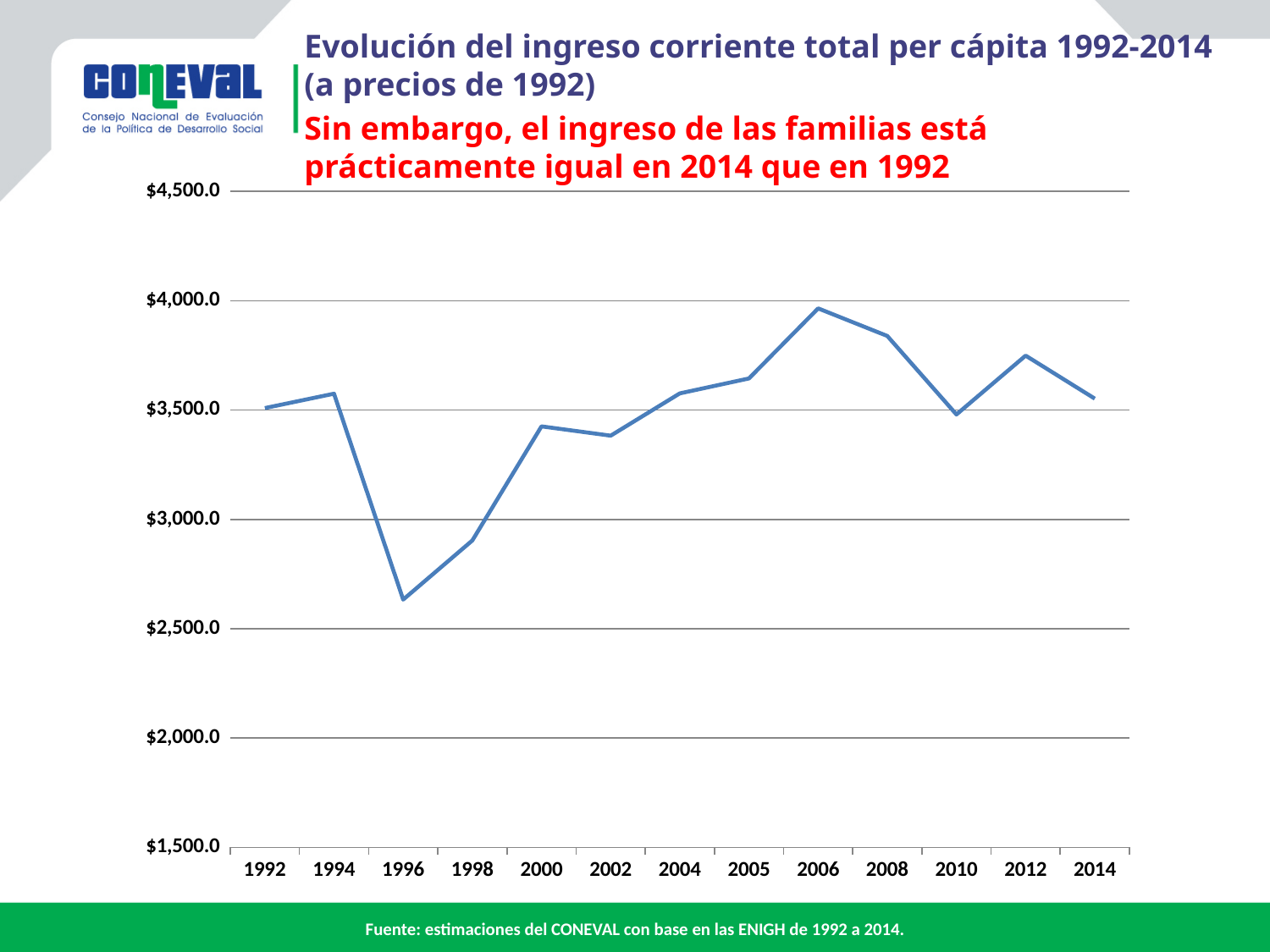
Is the value for 2012 greater or less than $3,500.0? greater Does the line rise or fall between 1994 and 1996? fall In which year is the ingreso corriente total per cápita highest? 2006 Which year has the larger value, 2008 or 2010? 2008 Is the value for 1996 greater or less than $3,000.0? less Is the value for 1998 greater or less than $3,000.0? less What kind of chart is shown on the slide? line chart In which year is the ingreso corriente total per cápita lowest? 1996 How many years are plotted along the x axis of the chart? 13 Which year has the larger value, 1994 or 1996? 1994 What is the title of the chart? Evolución del ingreso corriente total per cápita 1992-2014 (a precios de 1992)